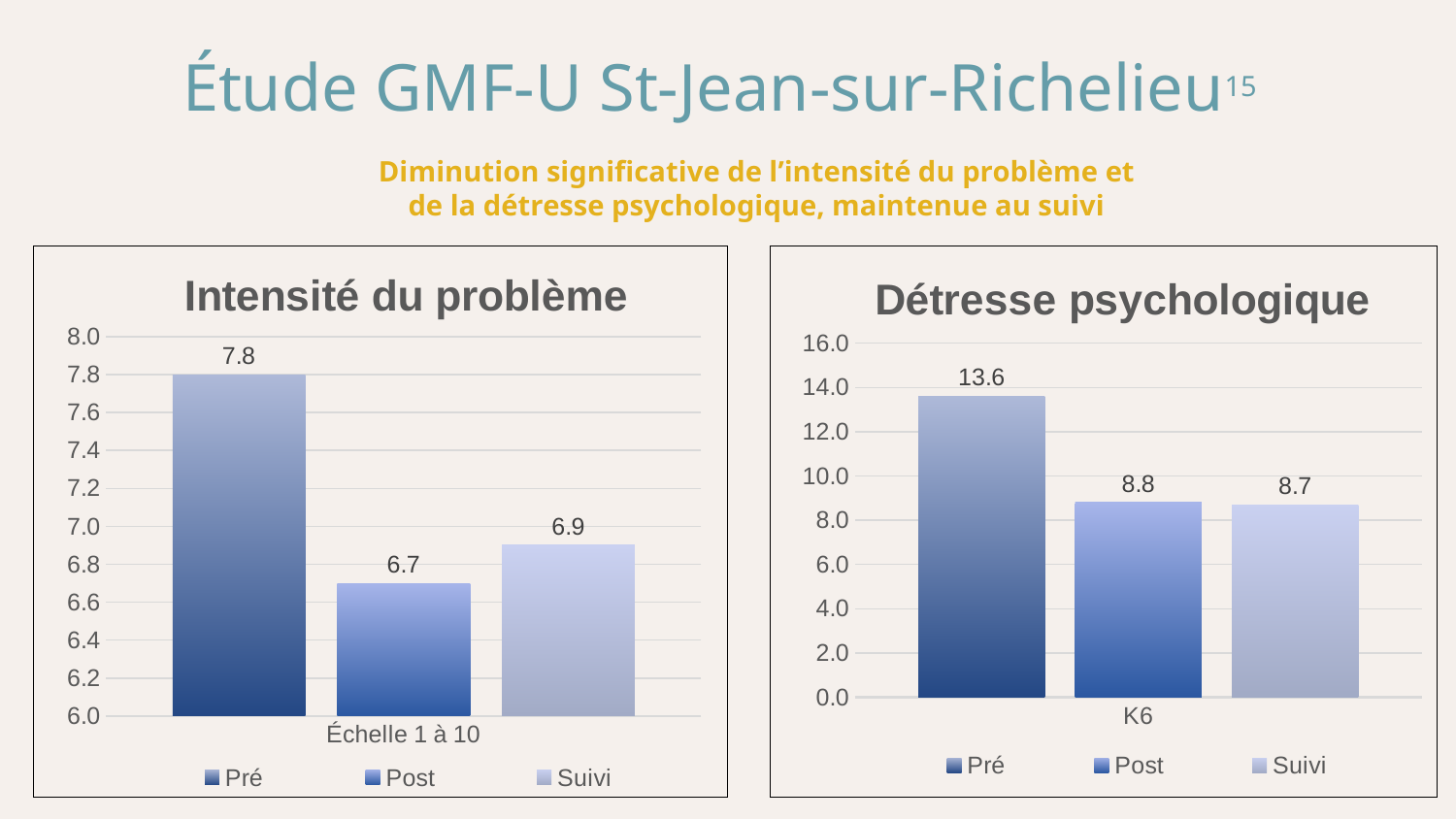
In the 'Intensité du problème' chart, what is the value for Post? 6.7 How many series does the legend of the 'Détresse psychologique' chart list? 3 In the 'Intensité du problème' chart, what is the difference between the Pré and Post values? 1.1 In the 'Détresse psychologique' chart, what is the value for Pré? 13.6 What kind of chart is the 'Intensité du problème' chart? Bar chart In the 'Intensité du problème' chart, what is the value for Pré? 7.8 What is the x-axis category label shown in the 'Détresse psychologique' chart? K6 In the 'Détresse psychologique' chart, what is the value for Suivi? 8.7 In the 'Détresse psychologique' chart, what is the difference between the Pré and Post values? 4.8 In the 'Intensité du problème' chart, which is larger, the Pré value or the Suivi value? Pré In the 'Intensité du problème' chart, which series has the lowest value? Post In the 'Détresse psychologique' chart, which series has the highest value? Pré